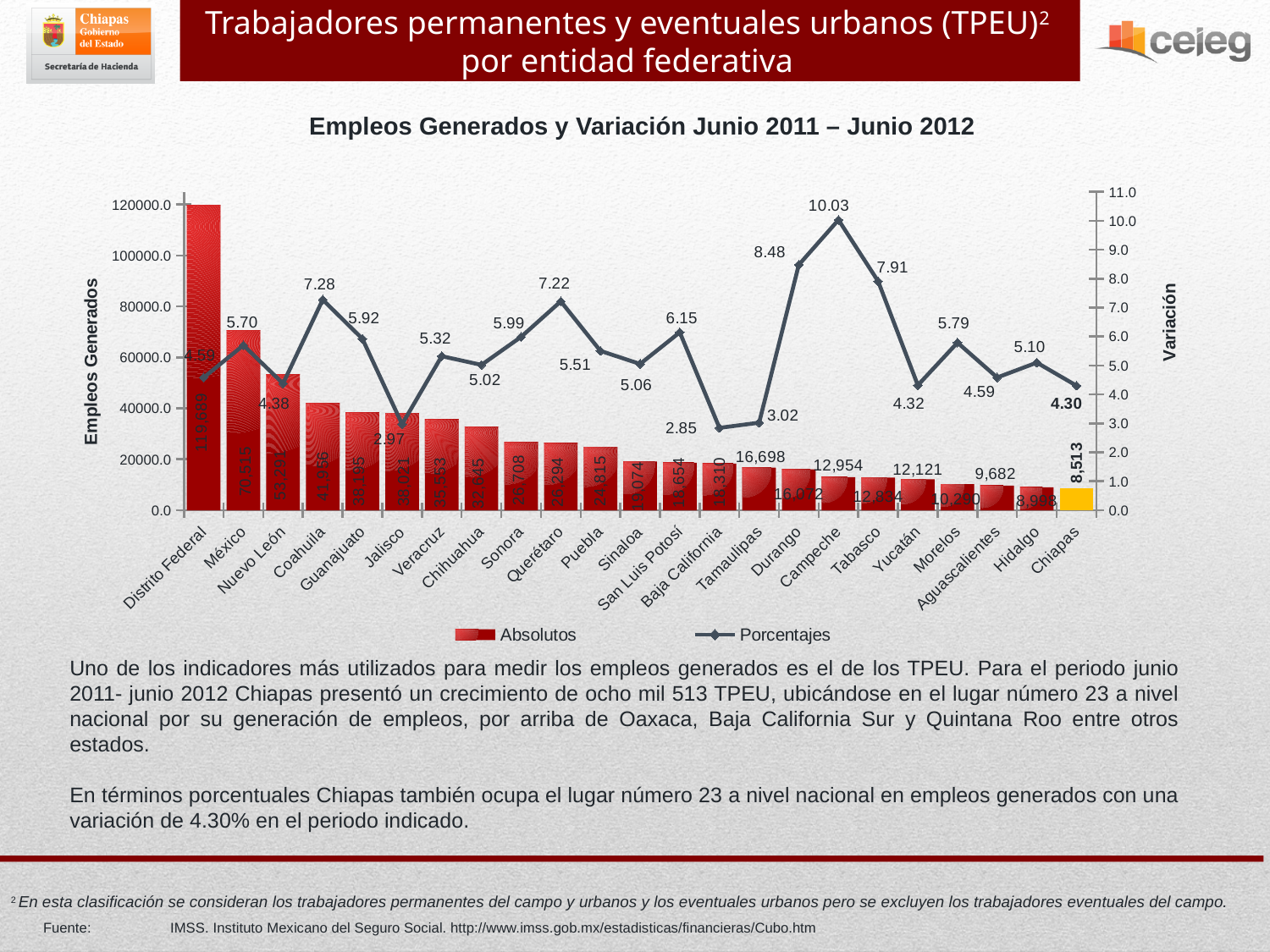
Which entidad has the highest Absolutos value? Distrito Federal How many entidades federativas are shown on the x axis? 23 Is the Absolutos value for Nuevo León greater or less than 40000.0? greater Which entidad has the highest Porcentajes value? Campeche What kind of chart is shown on the slide? A combined bar and line chart What is the difference between the Absolutos values for Distrito Federal and México? 49,174 What is the Porcentajes value for Campeche? 10.03 What is the Absolutos value for Aguascalientes? 9,682 Which has a higher Porcentajes value, Durango or Tabasco? Durango Which entidad has the lowest Porcentajes value? Baja California What is the Absolutos value for Chiapas? 8,513 How many series does the legend list? 2